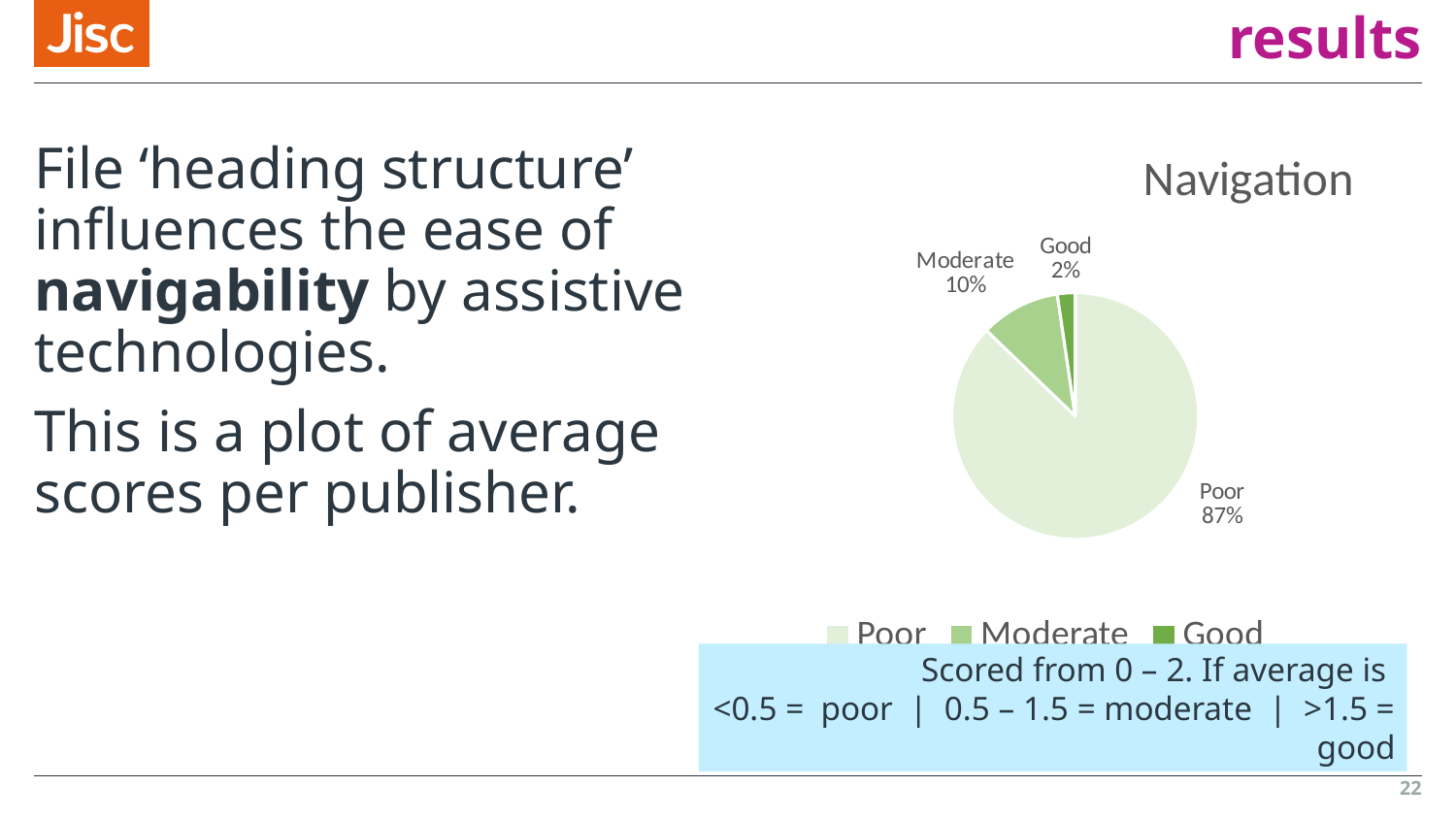
What is the difference in percentage points between the Poor and Moderate slices? 77 Which category has the smallest slice in the Navigation pie chart? Good What percentage of the Navigation pie chart is labelled Poor? 87% Which slice is larger, Moderate or Good? Moderate What percentage of the Navigation pie chart is labelled Good? 2% What percentage of the Navigation pie chart is labelled Moderate? 10% Which category has the largest slice in the Navigation pie chart? Poor What kind of chart is shown on the slide? pie chart How many entries does the legend of the Navigation pie chart list? 3 What is the difference in percentage points between the Moderate and Good slices? 8 How many slices does the Navigation pie chart have? 3 What is the title of the pie chart? Navigation